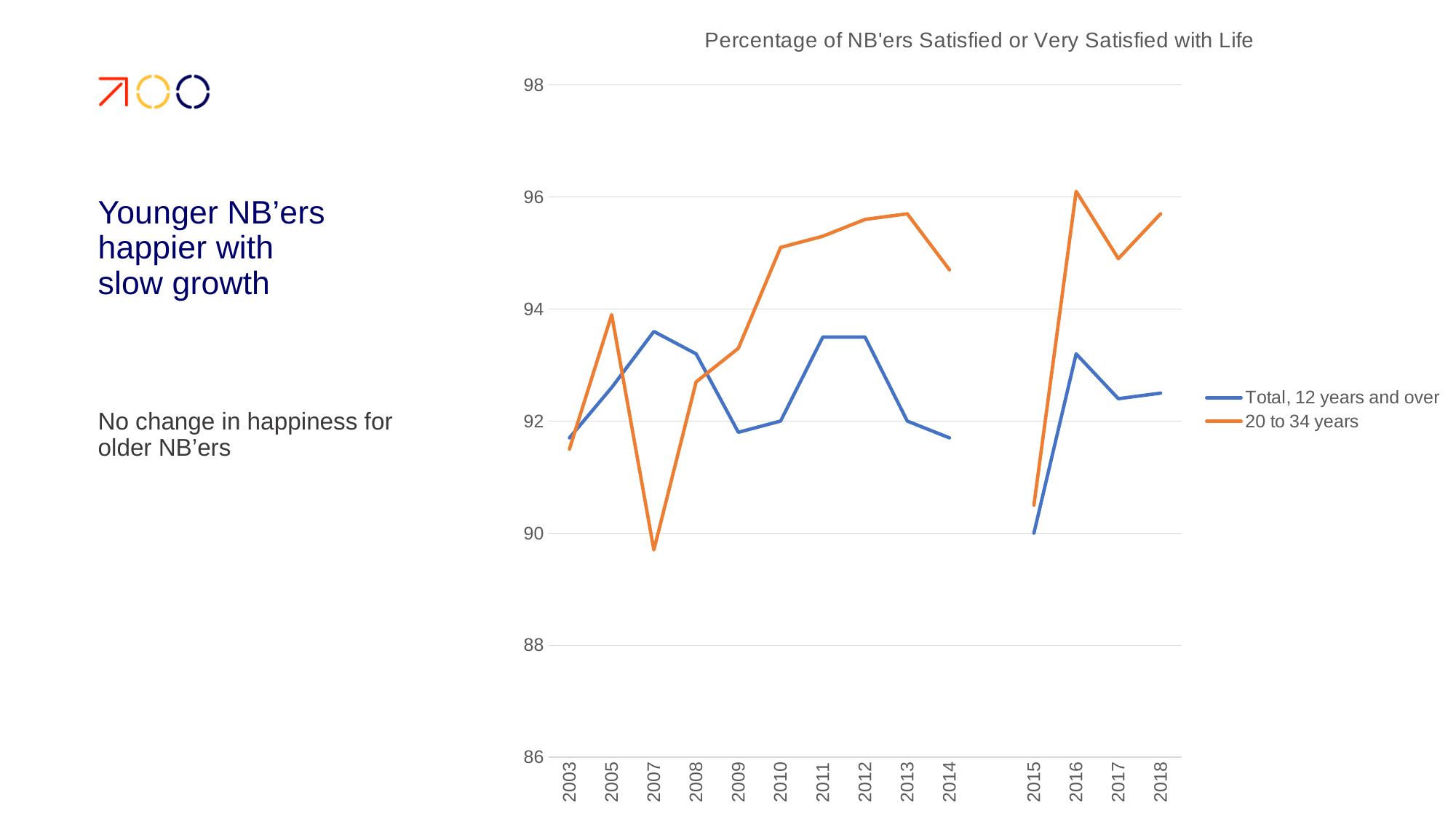
Is the value for 20 to 34 years in 2007 greater or less than 90? less In which year is the 20 to 34 years series at its lowest? 2007 What is the title of the chart? Percentage of NB'ers Satisfied or Very Satisfied with Life In 2007, which series has the higher value, Total, 12 years and over or 20 to 34 years? Total, 12 years and over How many series does the legend list? 2 How many years are shown along the x axis? 14 What kind of chart is shown on the slide? line chart In which year is the 20 to 34 years series at its highest? 2016 Does the 20 to 34 years series rise or fall from 2009 to 2013? rise What is the value for Total, 12 years and over in 2015? 90 Is the value for Total, 12 years and over in 2011 greater or less than 92? greater